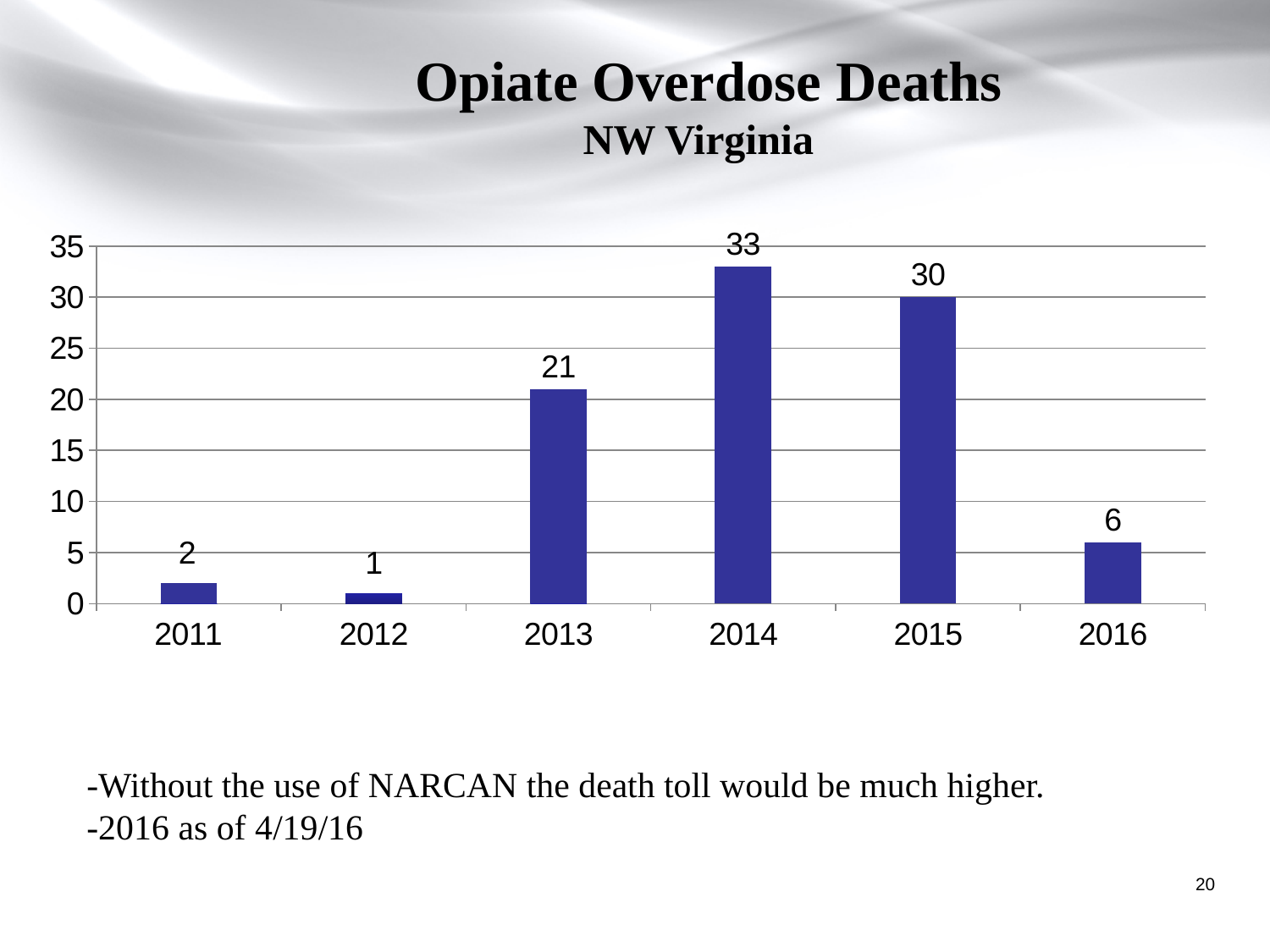
Which year has the highest value? 2014 What is the difference between the values for 2013 and 2011? 19 What is the value for 2012? 1 What is the value for 2014? 33 Which year has the lowest value? 2012 Which is larger, the value for 2013 or the value for 2016? 2013 How many years are shown on the x axis? 6 Is the value for 2015 greater or less than 25? greater What kind of chart is shown on the slide? bar chart What is the difference between the values for 2014 and 2015? 3 What is the value for 2016? 6 What is the title of the chart? Opiate Overdose Deaths NW Virginia